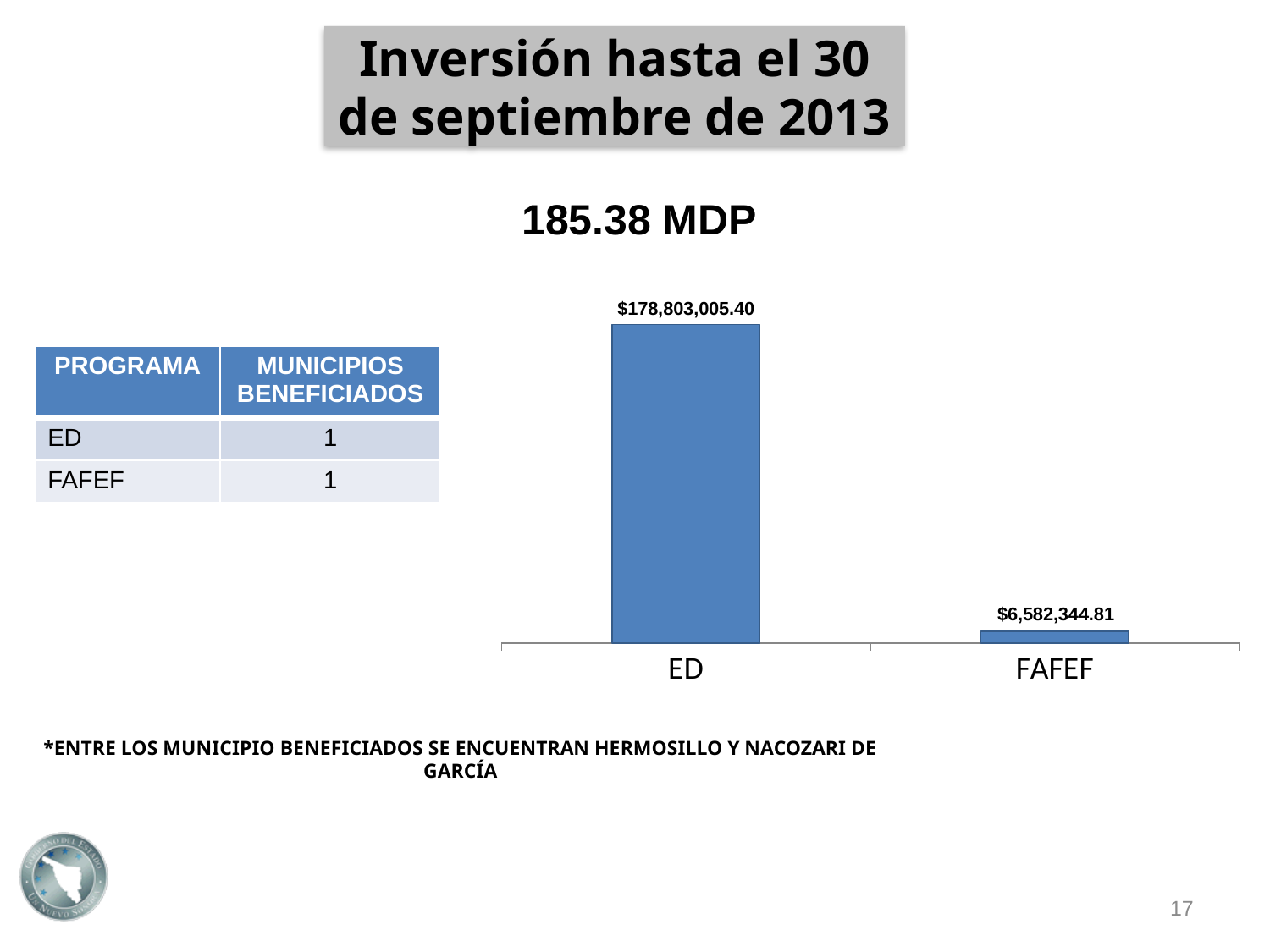
What colour are the bars in the chart? Blue What total amount in MDP is shown above the chart? 185.38 MDP Do the values rise or fall from ED to FAFEF along the x axis? Fall What is the value of the FAFEF bar? $6,582,344.81 Which category has the highest value in the chart? ED What is the value of the ED bar? $178,803,005.40 What kind of chart is shown on the slide? Bar chart Which is larger, the value for ED or the value for FAFEF? ED How many categories are shown in the chart? 2 Which category has the lowest value in the chart? FAFEF What is the difference between the ED value and the FAFEF value? $172,220,660.59